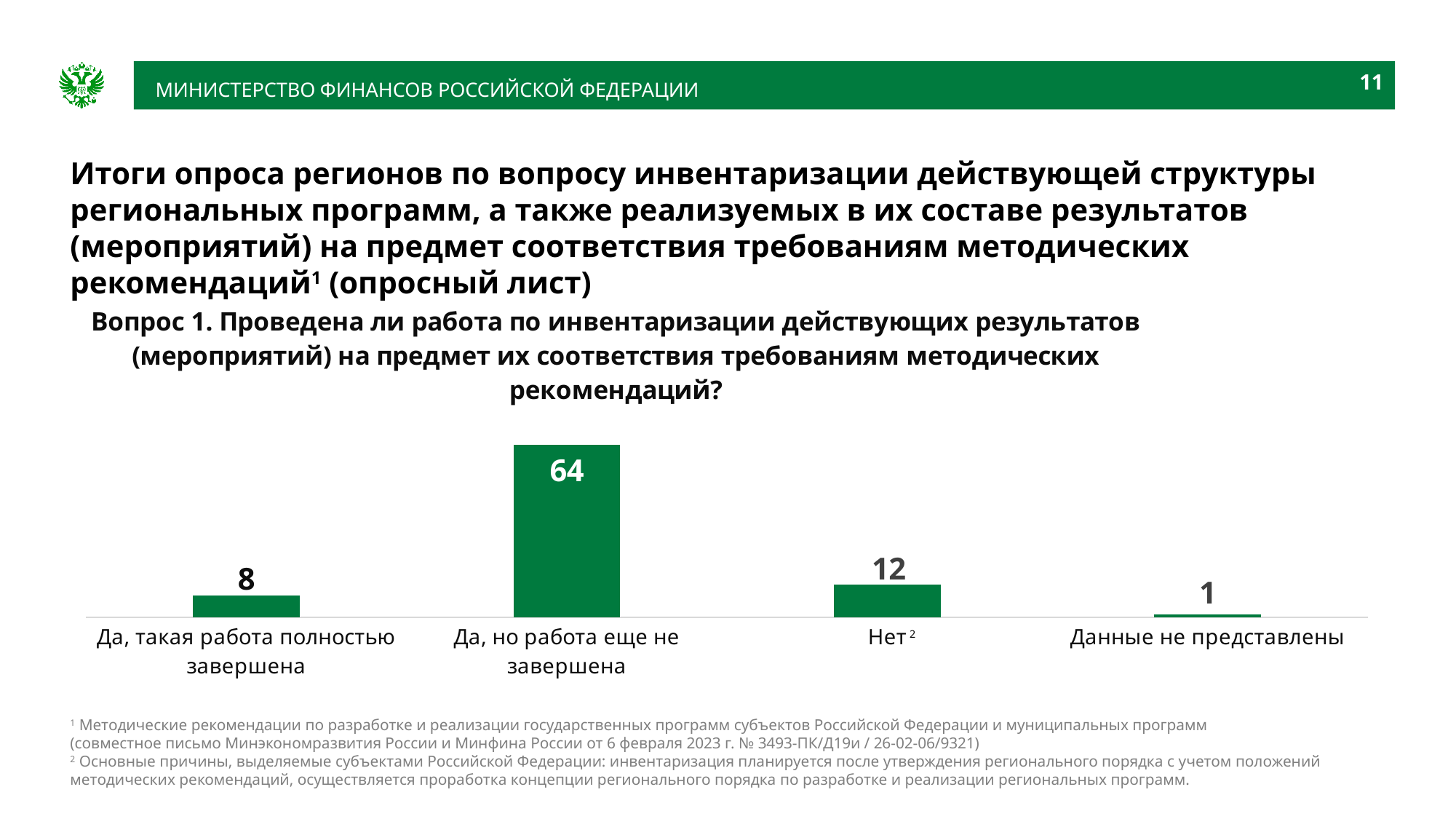
What is the value for the category "Нет"? 12 What is the value for the category "Да, но работа еще не завершена"? 64 What is the total of all four values shown in the chart? 85 What kind of chart is shown on the slide? Bar chart Which category has the highest value? Да, но работа еще не завершена What is the difference between the values for "Нет" and "Да, такая работа полностью завершена"? 4 What is the value for the category "Данные не представлены"? 1 Which is larger: the value for "Нет" or the value for "Да, такая работа полностью завершена"? Нет How many categories are shown in the chart? 4 What is the value for the category "Да, такая работа полностью завершена"? 8 What is the difference between the values for "Да, но работа еще не завершена" and "Нет"? 52 Which category has the lowest value? Данные не представлены